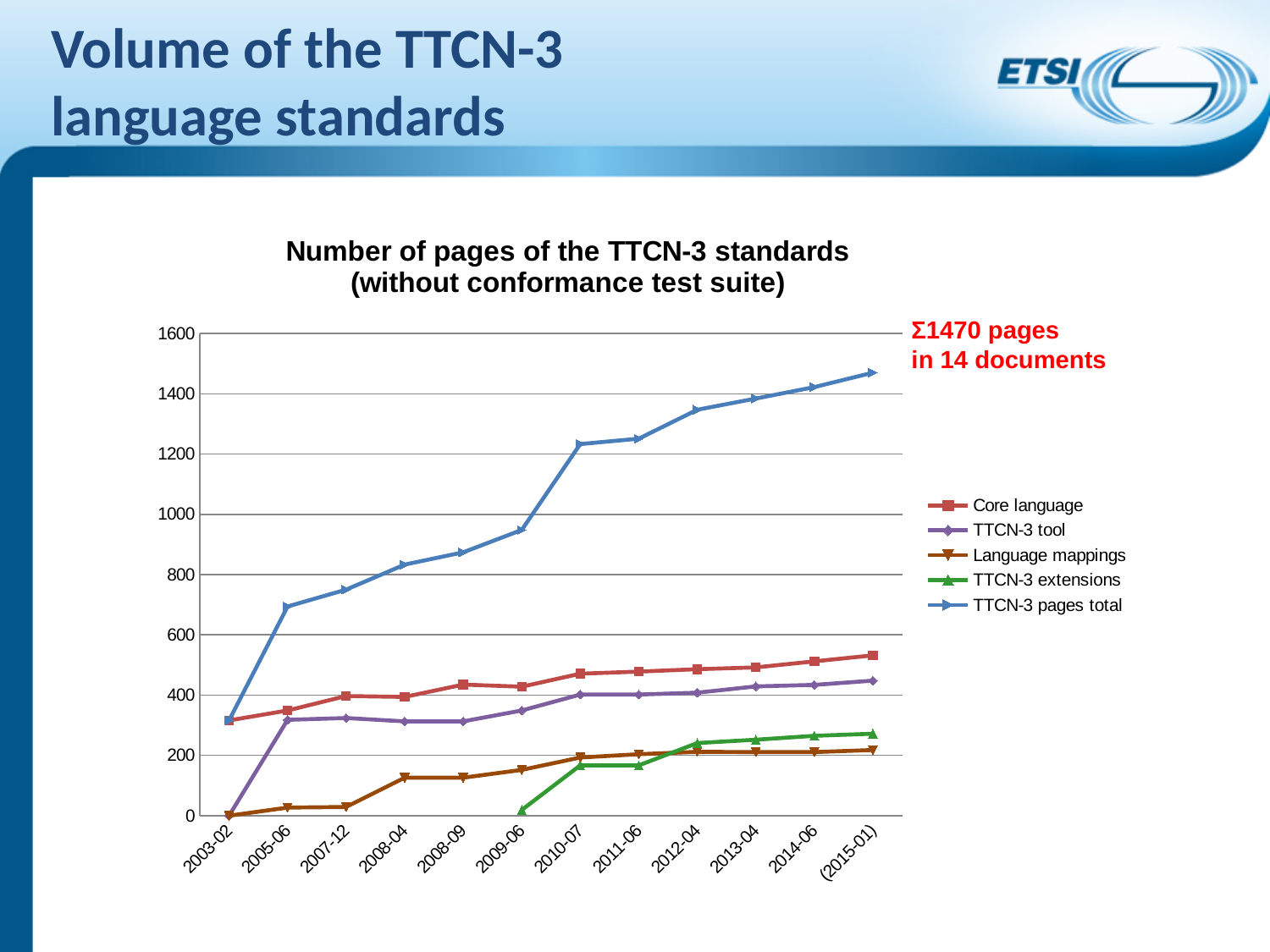
Which series has the highest value at (2015-01)? TTCN-3 pages total Is the value for TTCN-3 pages total at 2005-06 greater or less than 800? less What is the title of the chart? Number of pages of the TTCN-3 standards (without conformance test suite) How many series does the legend list? 5 Is the value for Language mappings at 2008-04 greater or less than 200? less What kind of chart is shown on the slide? line chart How many time points are shown on the x axis? 12 Does the TTCN-3 pages total series rise or fall from 2003-02 to (2015-01)? rise Which series is plotted in blue? TTCN-3 pages total Is the value for TTCN-3 pages total at 2010-07 greater or less than 1200? greater At (2015-01), which is larger: Core language or TTCN-3 tool? Core language